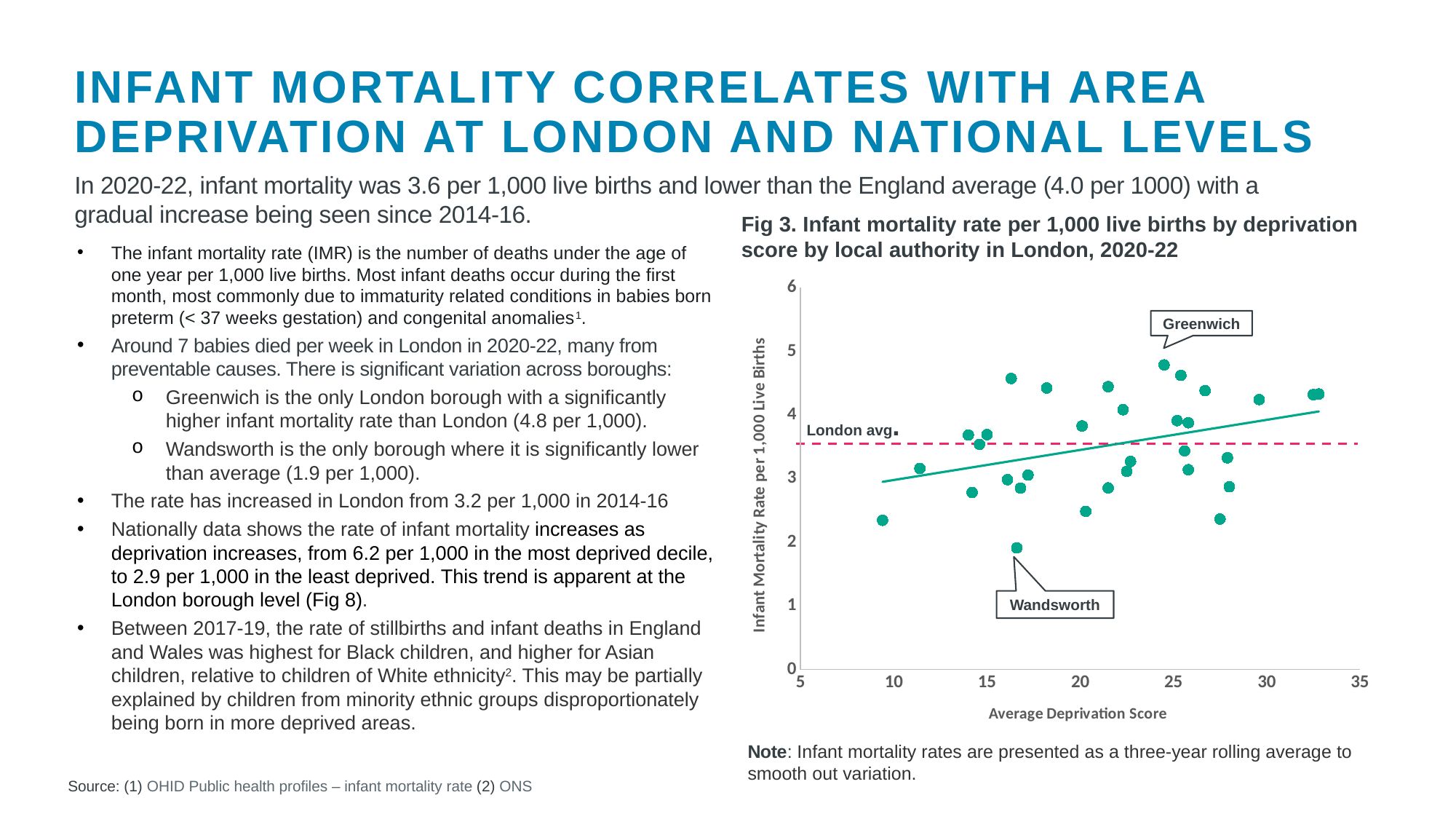
In Fig 3, is the London avg dashed line greater or less than 3 on the y axis? greater Which of the two labelled boroughs in Fig 3 has the higher infant mortality rate? Greenwich What is the x-axis title of Fig 3? Average Deprivation Score In Fig 3, is the infant mortality rate for Greenwich greater or less than 4? greater Which labelled borough in Fig 3 has the highest infant mortality rate? Greenwich In Fig 3, is the average deprivation score for Greenwich greater or less than 20? greater Which labelled borough in Fig 3 has the lowest infant mortality rate? Wandsworth In Fig 3, does the trend line rise or fall as the average deprivation score increases? rise What kind of chart is Fig 3? scatter chart What is the y-axis title of Fig 3? Infant Mortality Rate per 1,000 Live Births